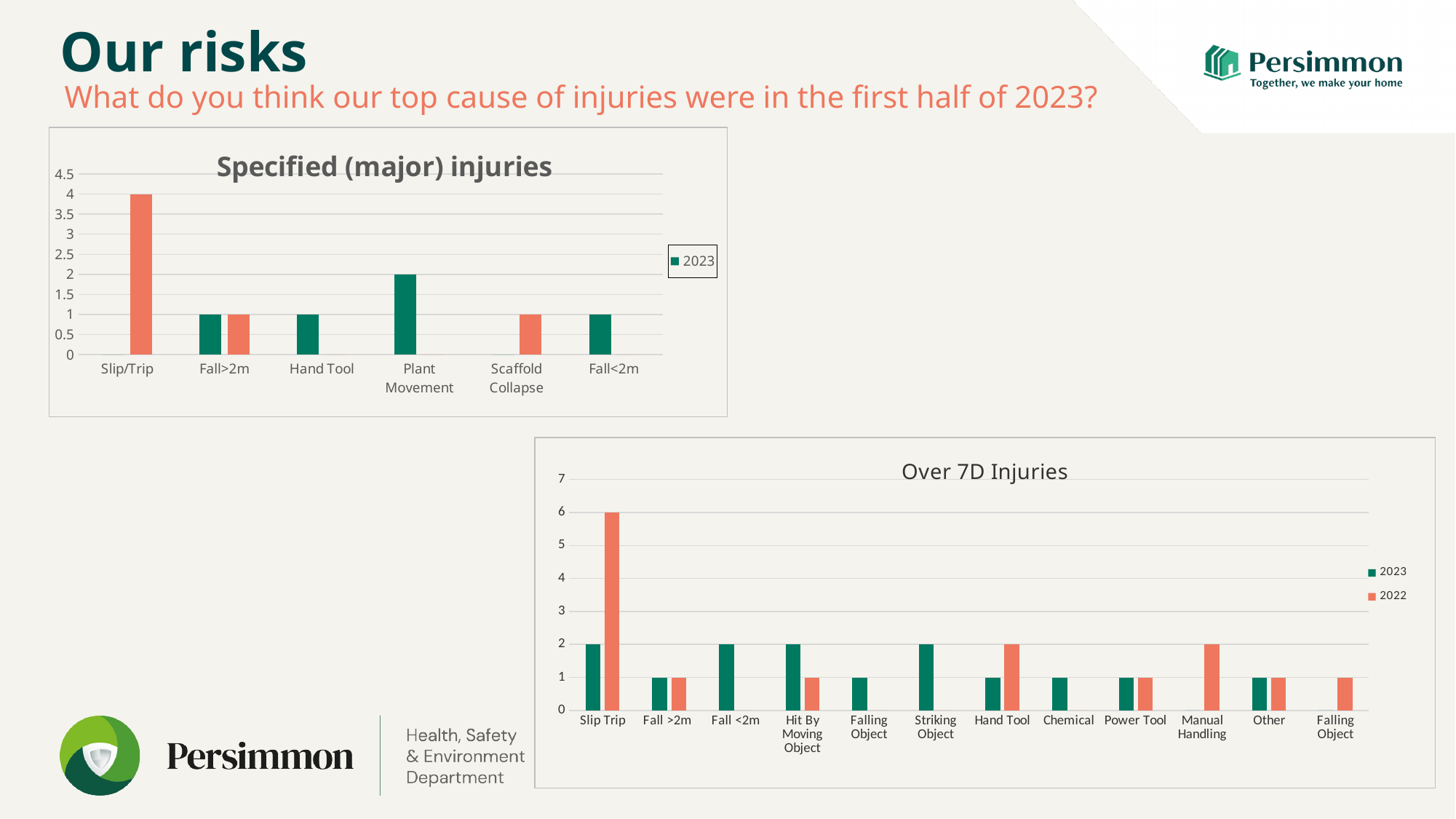
In the 'Over 7D Injuries' chart, what is the 2022 value for Slip Trip? 6 In the 'Over 7D Injuries' chart, how many categories are shown on the x axis? 12 In the 'Over 7D Injuries' chart, how many series does the legend list? 2 In the 'Specified (major) injuries' chart, what is the 2023 value for Plant Movement? 2 In the 'Over 7D Injuries' chart, which category has the highest 2022 value? Slip Trip In the 'Over 7D Injuries' chart, which is larger for Hand Tool: the 2023 value or the 2022 value? 2022 In the 'Specified (major) injuries' chart, how many categories are shown on the x axis? 6 What kind of chart is the 'Specified (major) injuries' chart? bar chart In the 'Over 7D Injuries' chart, what is the difference between the 2022 and 2023 values for Slip Trip? 4 In the 'Specified (major) injuries' chart, which category has the tallest bar? Slip/Trip In the 'Specified (major) injuries' chart, what is the 2023 value for Hand Tool? 1 In the 'Over 7D Injuries' chart, what is the 2023 value for Hit By Moving Object? 2